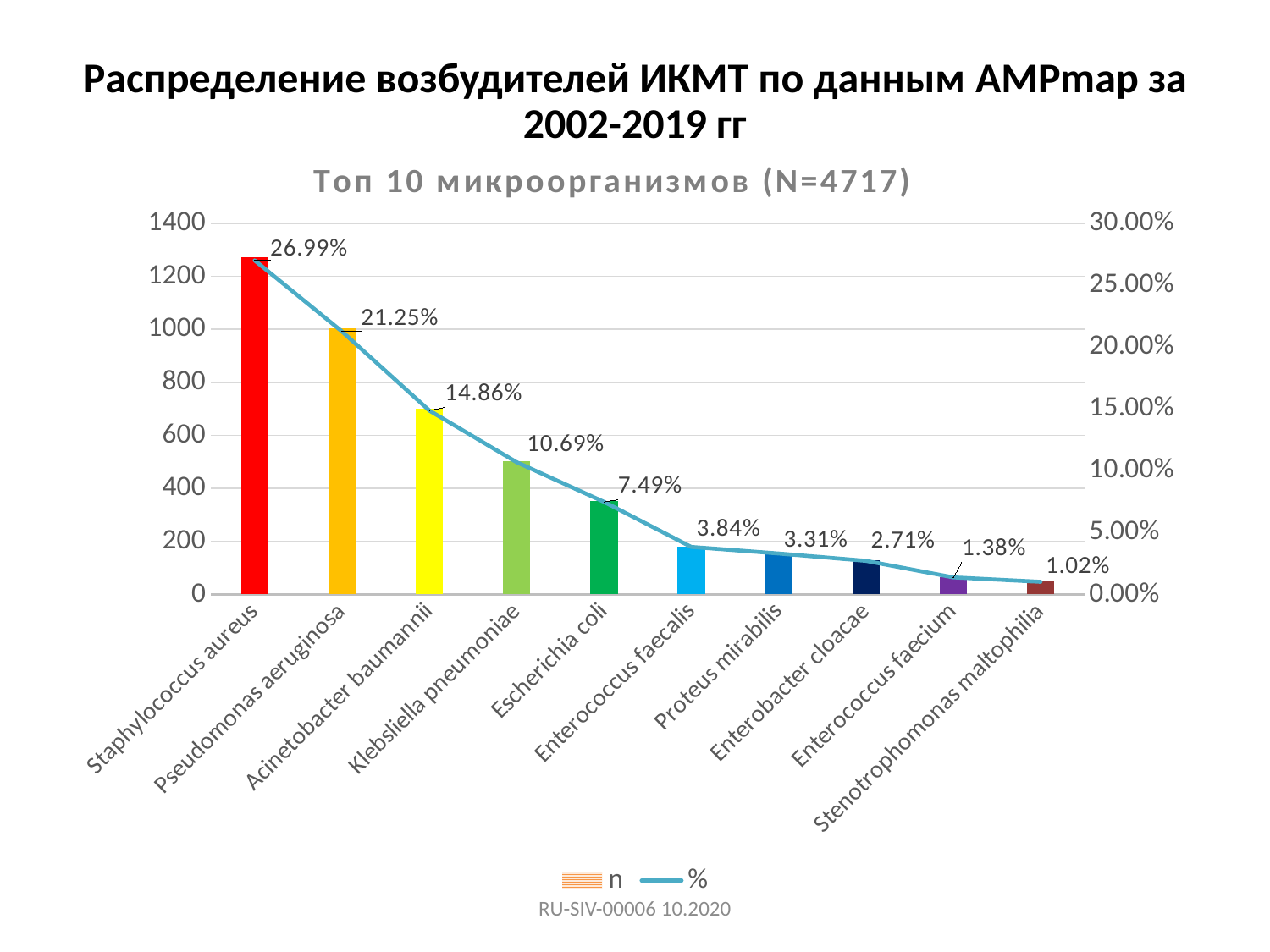
How many microorganisms are shown on the x axis? 10 What percentage is shown for Staphylococcus aureus? 26.99% Is the n value for Staphylococcus aureus greater or less than 1200? greater Is the n value for Escherichia coli greater or less than 400? less Which microorganism has the highest percentage? Staphylococcus aureus Which microorganism has the lowest percentage? Stenotrophomonas maltophilia Do the percentage values rise or fall from left to right along the x axis? fall What percentage is shown for Enterococcus faecium? 1.38% What percentage is shown for Klebsiella pneumoniae? 10.69% What is the difference in percentage between Pseudomonas aeruginosa and Acinetobacter baumannii? 6.39% How many series does the legend list? 2 Which has a larger percentage, Escherichia coli or Enterococcus faecalis? Escherichia coli